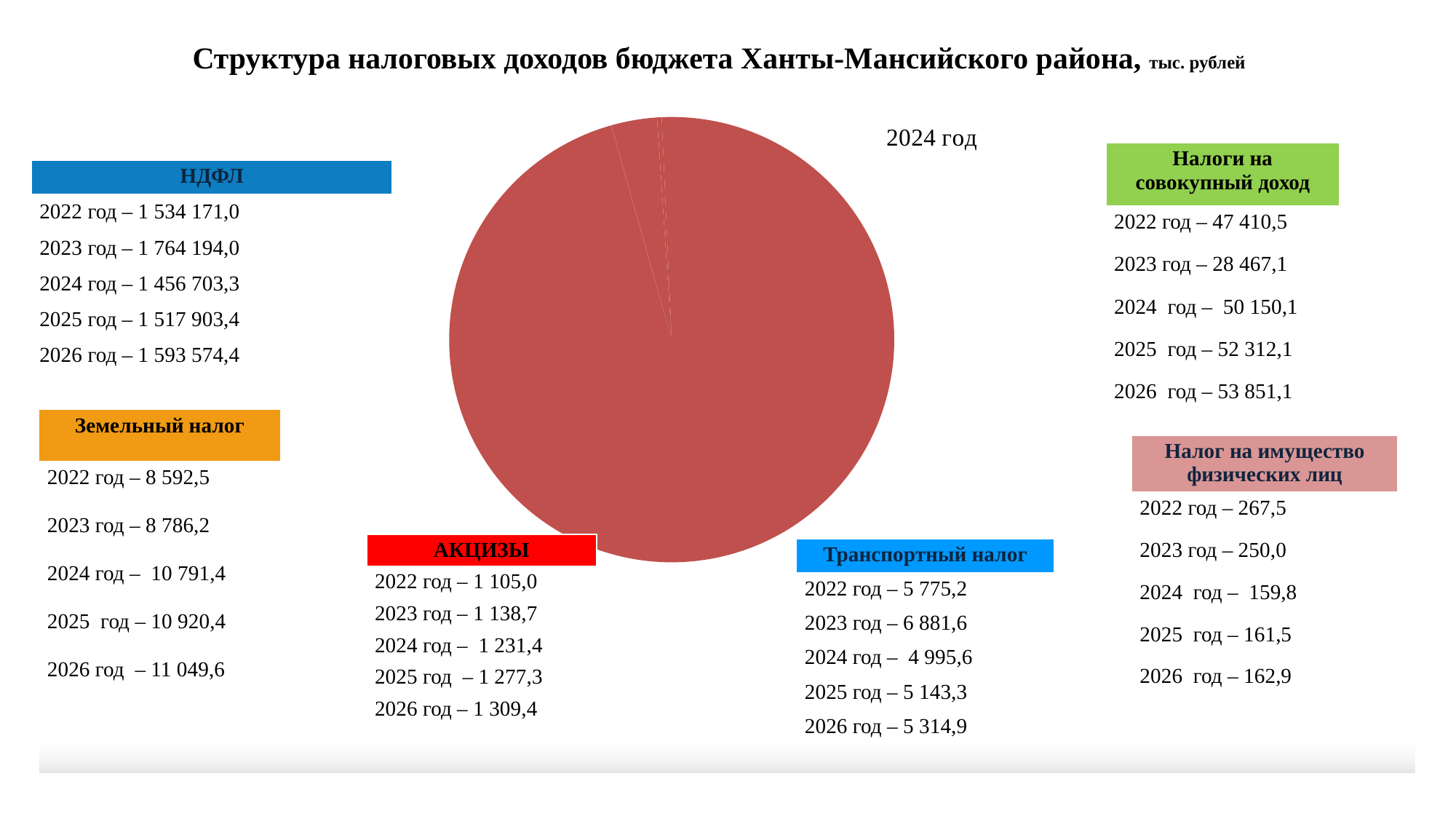
What kind of chart is shown on the slide? pie chart How many tax categories are listed around the pie chart? 6 Which year does the pie chart represent? 2024 год Which tax category has the lowest value for 2024 год? Налог на имущество физических лиц What is the value of Земельный налог for 2024 год? 10 791,4 Which tax category has the highest value for 2024 год? НДФЛ What is the difference between Земельный налог and Транспортный налог for 2024 год? 5 795,8 What is the value of НДФЛ for 2024 год? 1 456 703,3 What is the value of Налоги на совокупный доход for 2024 год? 50 150,1 Which is larger for 2024 год: Акцизы or Транспортный налог? Транспортный налог What is the title of the slide above the pie chart? Структура налоговых доходов бюджета Ханты-Мансийского района, тыс. рублей What is the value of Транспортный налог for 2024 год? 4 995,6